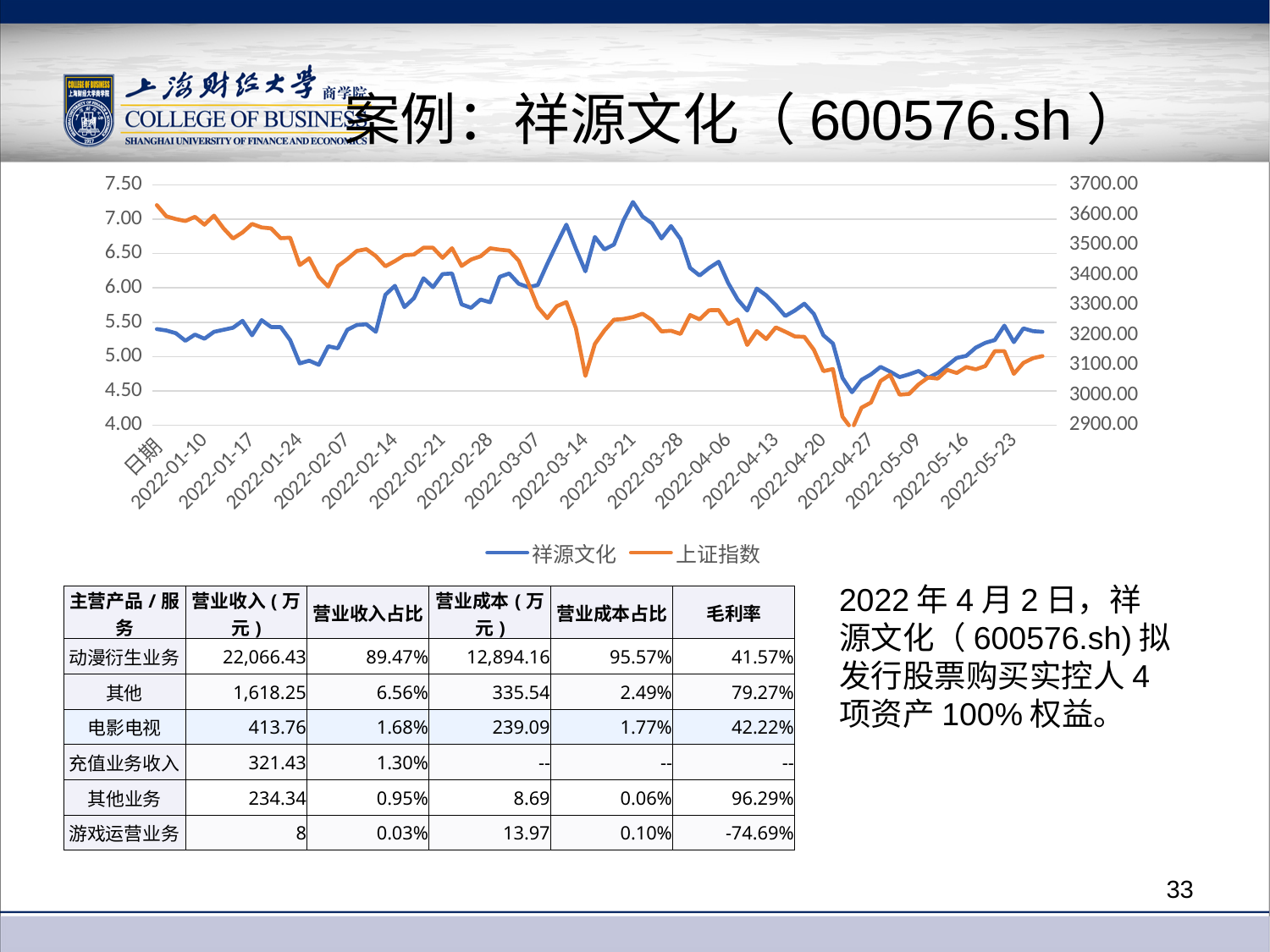
Does the 祥源文化 line rise or fall between 2022-03-21 and 2022-04-27? fall Is the lowest value of 上证指数 around 2022-04-27 greater or less than 3000.00? less Which series is drawn in orange in the chart? 上证指数 Is the value of 祥源文化 around 2022-04-27 greater or less than 5.00? less Is the value of 上证指数 at 2022-01-10 greater or less than 3500.00? greater What kind of chart is shown on the slide? line chart How many series does the chart legend list? 2 Does the 上证指数 line overall rise or fall from 2022-01-10 to 2022-05-23? fall What is the highest tick value shown on the left vertical axis of the chart? 7.50 What are the two series named in the chart legend? 祥源文化 and 上证指数